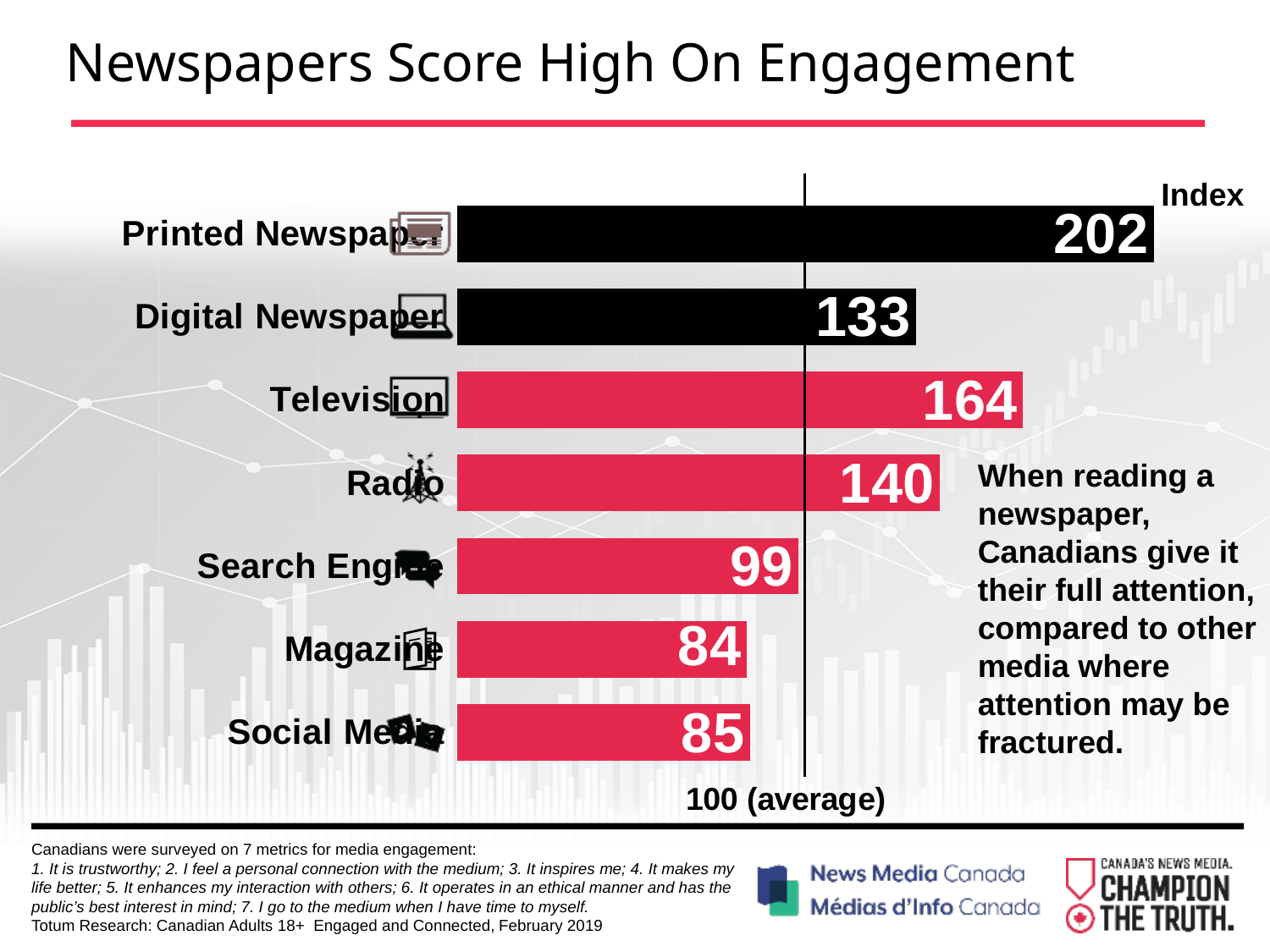
What type of chart is shown on the slide? Bar chart What is the engagement index value for Search Engine? 99 Is the value for Radio greater or less than 100? greater What value does the vertical reference line in the chart represent? 100 (average) Which medium has the lowest engagement index? Magazine What is the engagement index value for Television? 164 What is the engagement index value for Printed Newspaper? 202 What is the difference between the index values for Social Media and Magazine? 1 How many media categories are shown in the chart? 7 Which medium has the highest engagement index? Printed Newspaper What is the difference between the index values for Printed Newspaper and Digital Newspaper? 69 Which has a higher engagement index, Television or Radio? Television